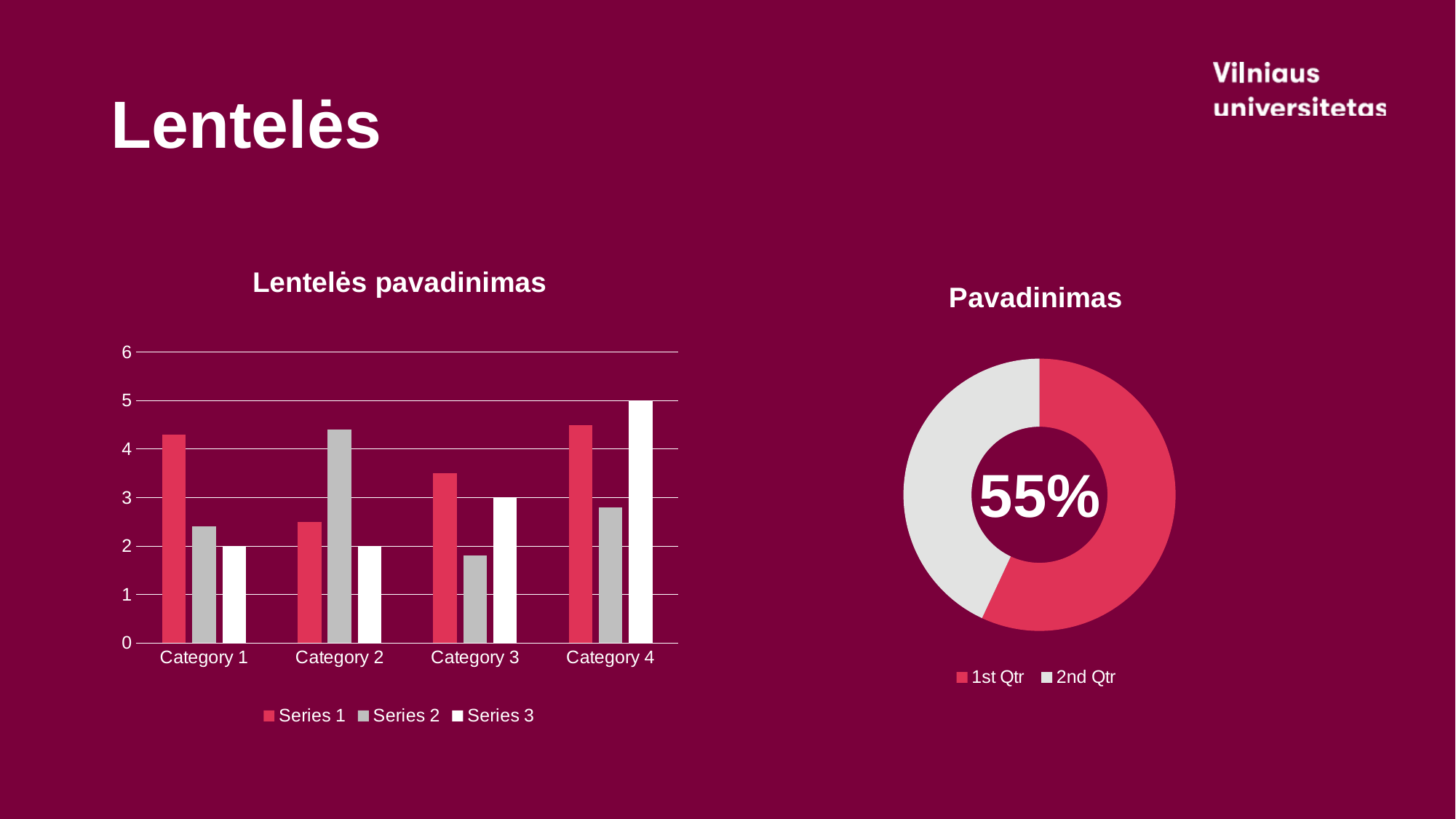
In the chart titled "Lentelės pavadinimas", what is the value of Series 3 for Category 4? 5 In the chart titled "Lentelės pavadinimas", how many series does the legend list? 3 What kind of chart is the chart titled "Pavadinimas"? donut (pie) chart What kind of chart is the chart titled "Lentelės pavadinimas"? bar chart In the chart titled "Lentelės pavadinimas", is the value of Series 1 for Category 1 greater or less than 4? greater In the chart titled "Lentelės pavadinimas", what is the value of Series 3 for Category 3? 3 In the chart titled "Lentelės pavadinimas", which is larger for Category 2: Series 1 or Series 2? Series 2 In the chart titled "Lentelės pavadinimas", is the value of Series 2 for Category 3 greater or less than 2? less In the chart titled "Pavadinimas", how many entries does the legend list? 2 In the chart titled "Lentelės pavadinimas", which category has the highest Series 3 value? Category 4 In the chart titled "Pavadinimas", what percentage is printed in the centre of the donut? 55% In the chart titled "Lentelės pavadinimas", how many categories are shown on the x axis? 4